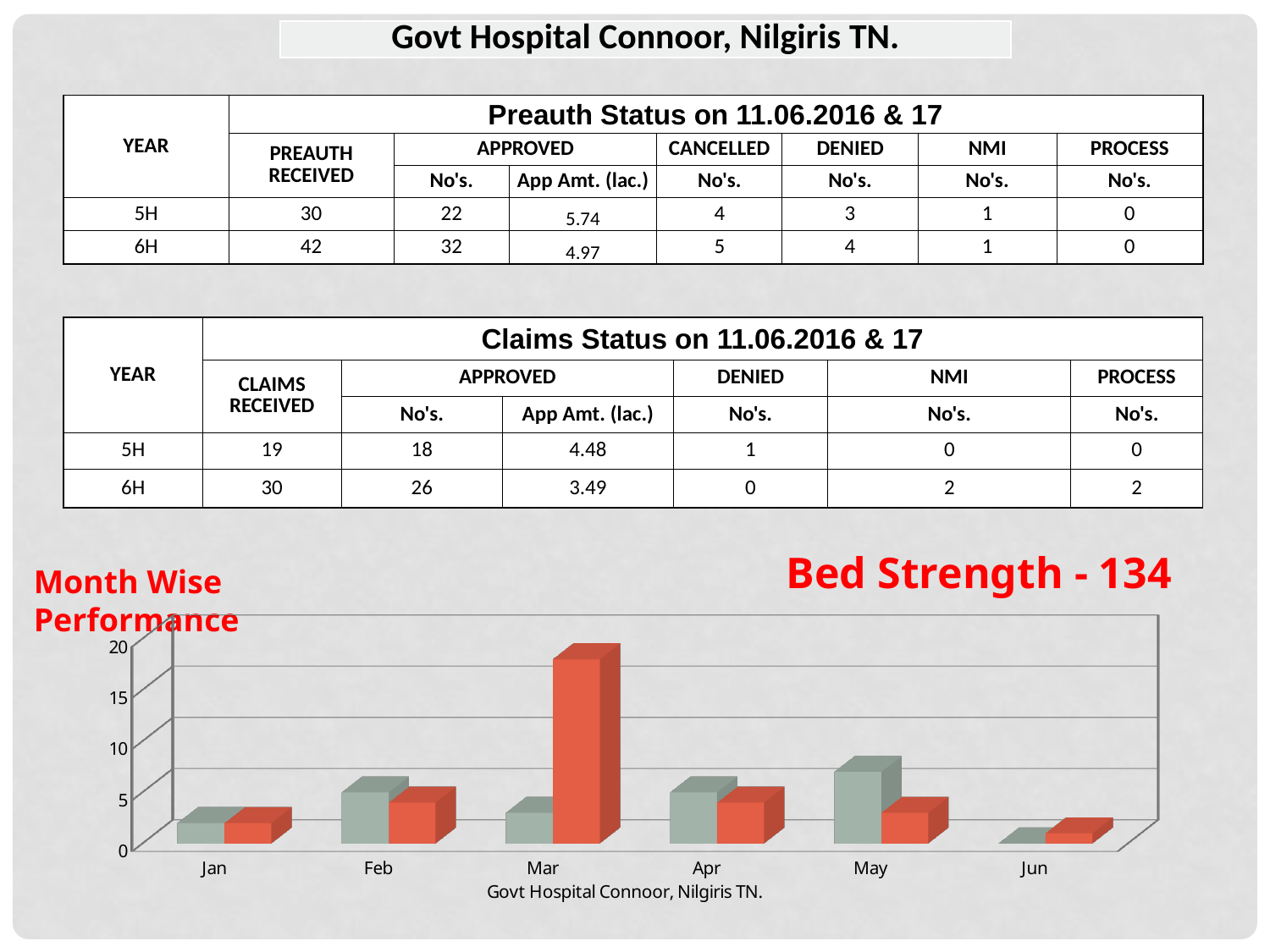
Is the red bar for Mar greater or less than 15? greater Is the red bar for Jun greater or less than 5? less In May, which bar is taller, the green bar or the red bar? the green bar In which month is the green bar the shortest? Jun Is the green bar for May greater or less than 5? greater In which month is the green bar the tallest? May What text appears below the x axis of the chart? Govt Hospital Connoor, Nilgiris TN. In Mar, which bar is taller, the green bar or the red bar? the red bar In which month is the red bar the tallest? Mar What kind of chart is shown at the bottom of the slide? bar chart How many months are shown on the x axis of the chart? 6